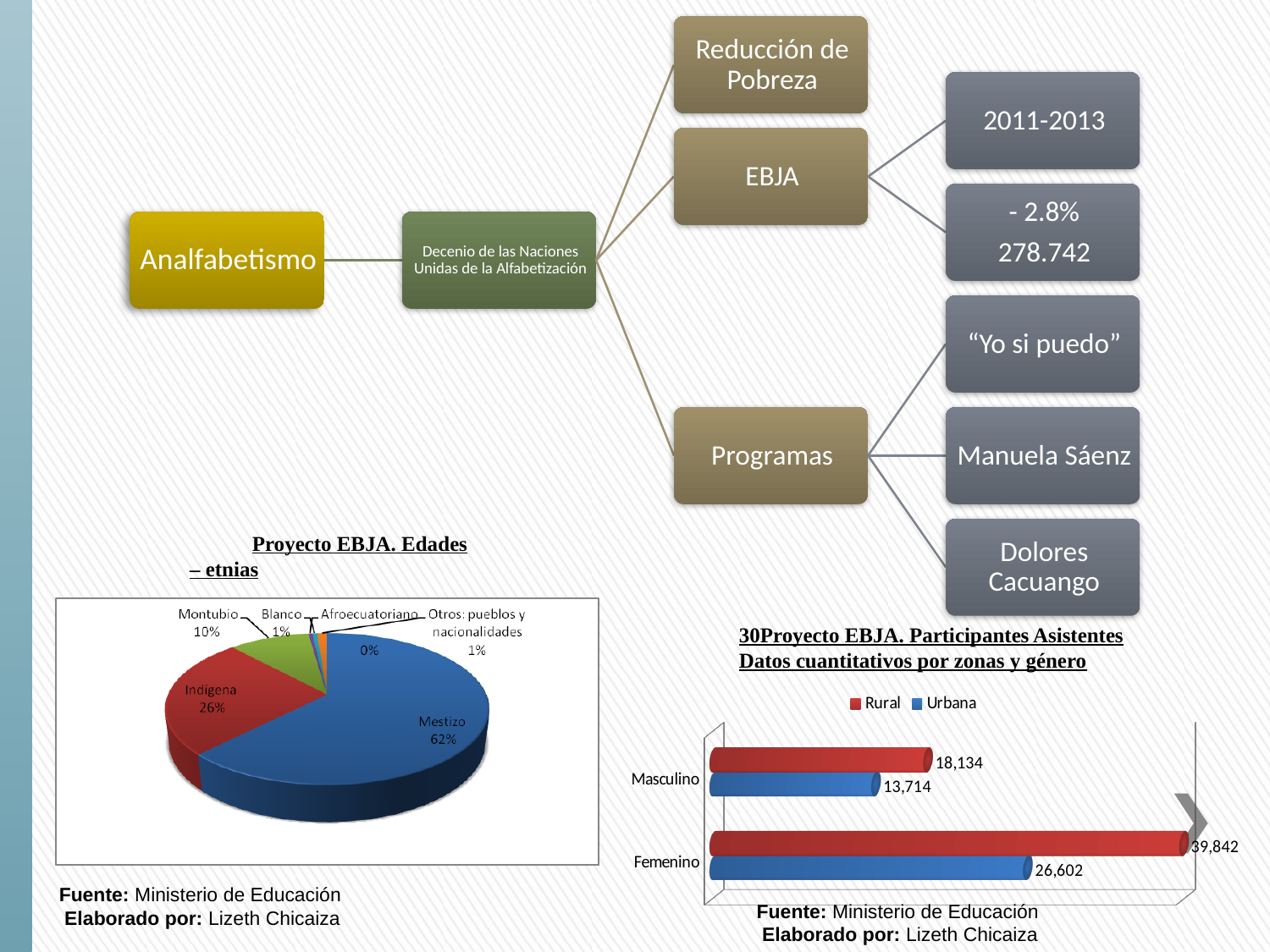
In the pie chart 'Proyecto EBJA. Edades – etnias', what share does Mestizo have? 62% In the pie chart 'Proyecto EBJA. Edades – etnias', how many categories are labelled? 6 In the bar chart 'Proyecto EBJA. Participantes Asistentes', what is the Rural value for Femenino? 39,842 What kind of chart is 'Proyecto EBJA. Edades – etnias'? Pie chart What kind of chart is 'Proyecto EBJA. Participantes Asistentes'? Bar chart In the bar chart 'Proyecto EBJA. Participantes Asistentes', what is the difference between the Rural and Urbana values for Femenino? 13,240 In the pie chart 'Proyecto EBJA. Edades – etnias', what share does Indígena have? 26% In the pie chart 'Proyecto EBJA. Edades – etnias', which category has the largest slice? Mestizo In the bar chart 'Proyecto EBJA. Participantes Asistentes', what is the Urbana value for Masculino? 13,714 In the pie chart 'Proyecto EBJA. Edades – etnias', what is the percentage shown for Montubio? 10% How many series does the legend of the bar chart 'Proyecto EBJA. Participantes Asistentes' list? 2 In the bar chart 'Proyecto EBJA. Participantes Asistentes', which is larger for Masculino: Rural or Urbana? Rural